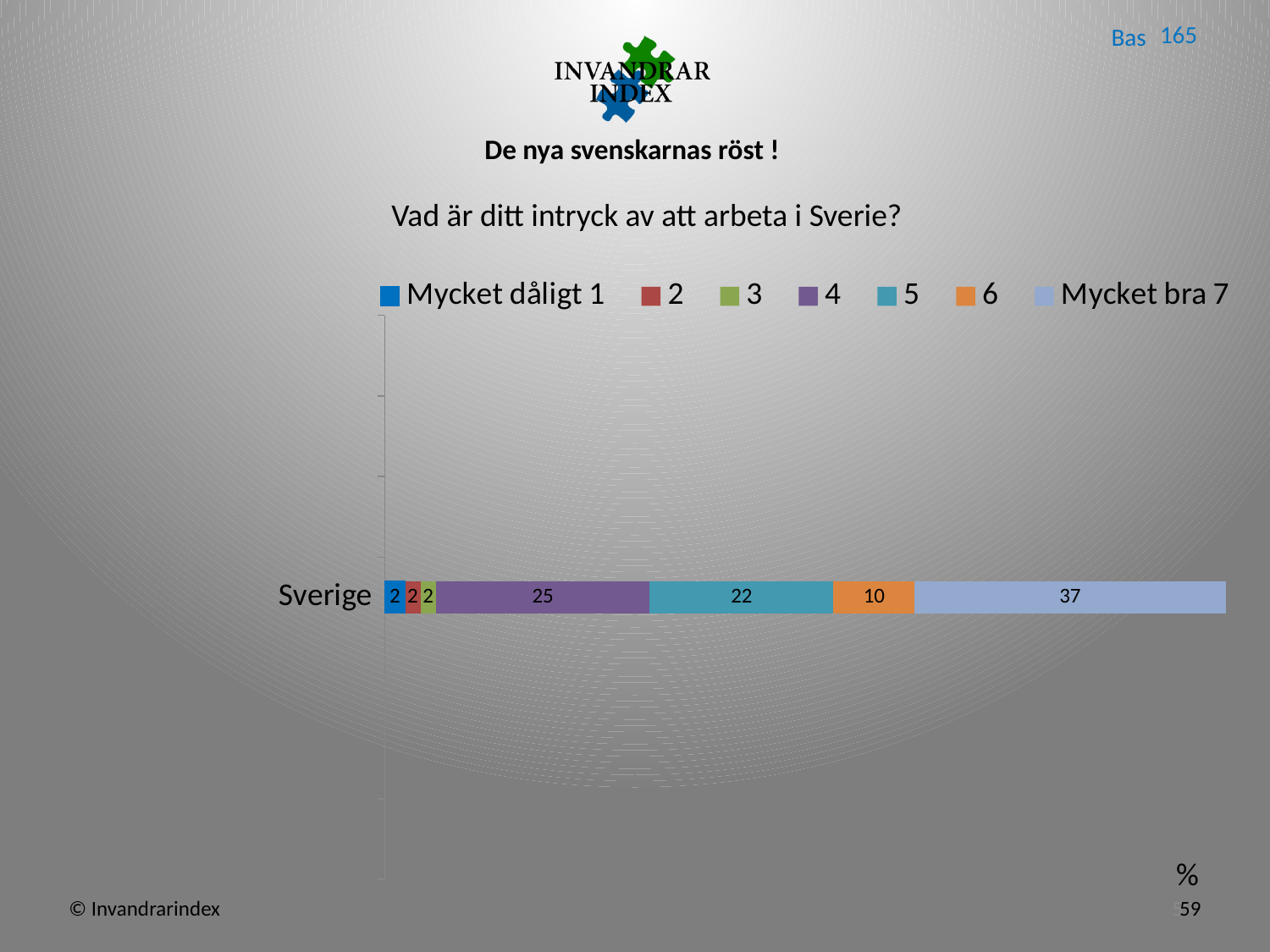
What is the difference between the values for 'Mycket bra 7' and series '4' for Sverige? 12 How many series does the legend list? 7 What is the value for series '6' for Sverige? 10 What is the value for series '4' for Sverige? 25 How many categories are plotted on the chart? 1 What is the value for 'Mycket bra 7' for Sverige? 37 Which series has the largest value for Sverige? Mycket bra 7 What is the total of the stacked bar for Sverige? 100 What is the value for 'Mycket dåligt 1' for Sverige? 2 What kind of chart is shown on the slide? Stacked bar chart What is the value for series '5' for Sverige? 22 Which is larger for Sverige, the value for series '5' or series '6'? 5